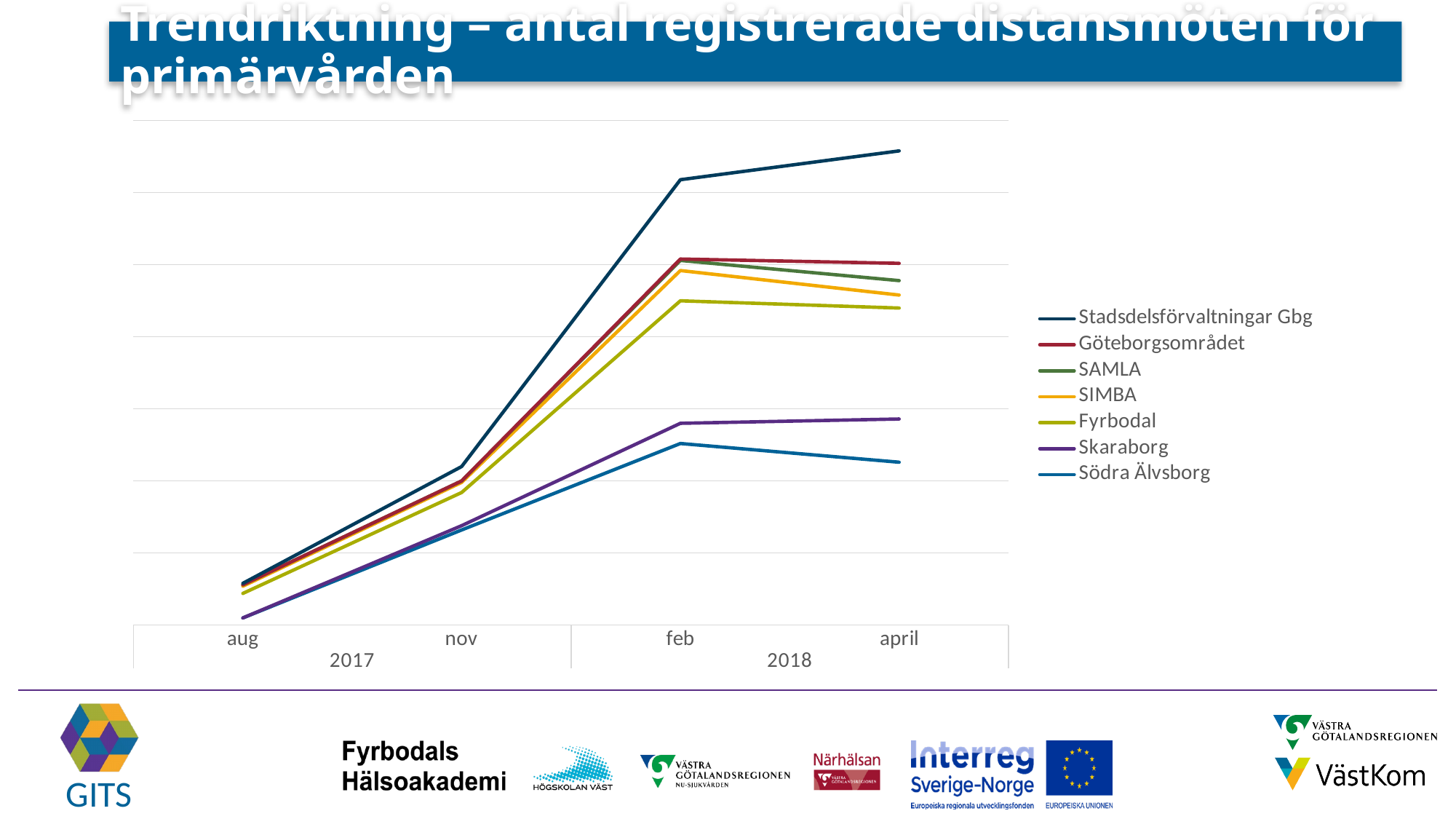
How many series does the legend list? 7 In april 2018, which is higher: Skaraborg or Södra Älvsborg? Skaraborg How many time points are shown along the x axis? 4 Which series has the lowest value in april 2018? Södra Älvsborg Which two years are labelled on the x axis? 2017 and 2018 In april 2018, which is higher: SIMBA or Fyrbodal? SIMBA Which series has the lowest value in aug 2017? Skaraborg What kind of chart is shown on the slide? line chart Which series is listed first in the legend? Stadsdelsförvaltningar Gbg Does the Södra Älvsborg line rise or fall between feb 2018 and april 2018? fall Which series has the highest value in april 2018? Stadsdelsförvaltningar Gbg Does the Stadsdelsförvaltningar Gbg line rise or fall from aug 2017 to april 2018? rise